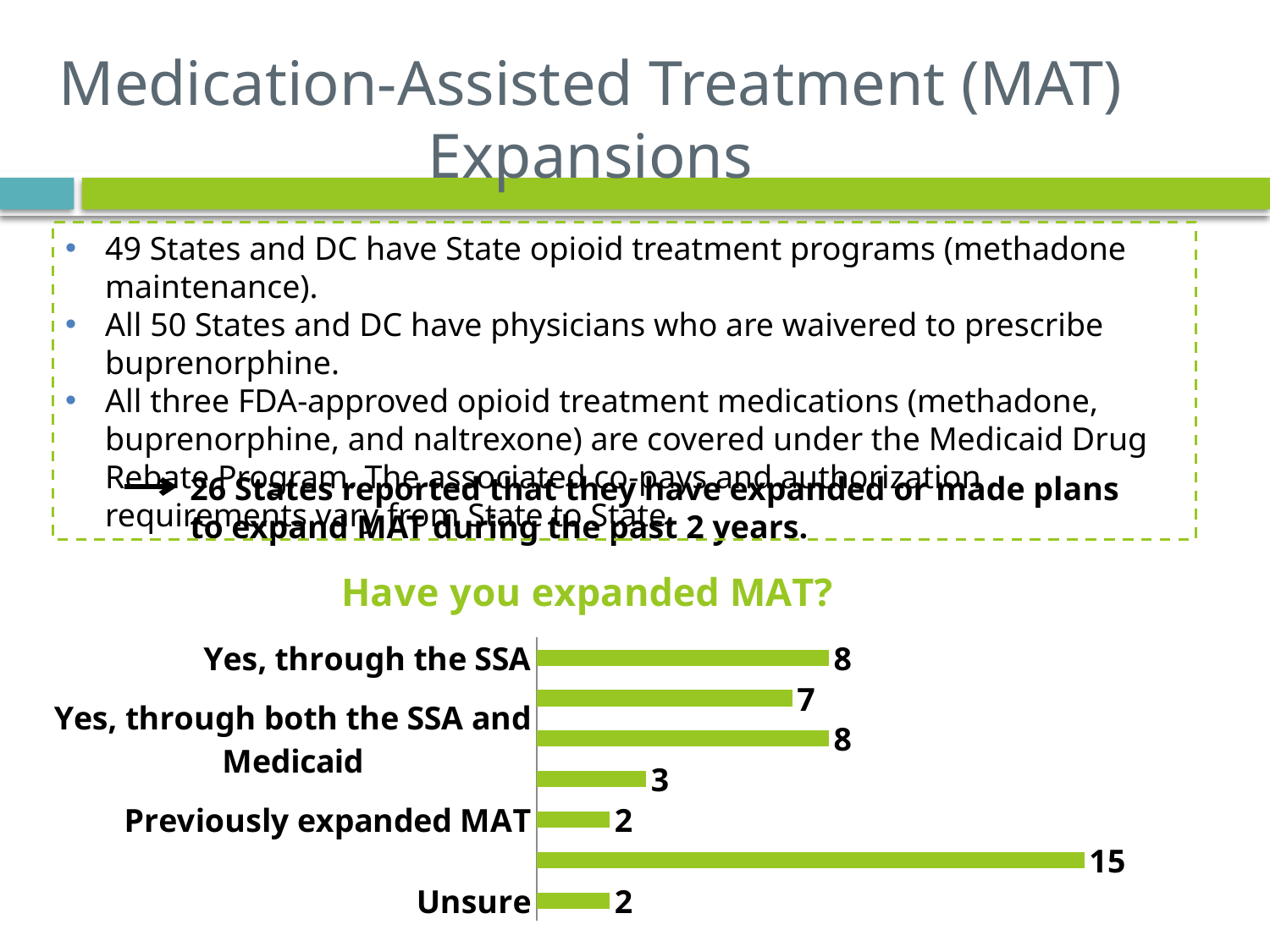
How many bars does the chart show? 7 What is the value for "Yes, through the SSA"? 8 Which is larger, the value for "Yes, through the SSA" or the value for "Unsure"? Yes, through the SSA What colour are the bars in the chart? green What is the sum of all the bar values shown in the chart? 45 What is the value for "Yes, through both the SSA and Medicaid"? 8 What is the value for "Previously expanded MAT"? 2 What kind of chart is shown on the slide? bar chart What is the difference between the value for "Yes, through the SSA" and the value for "Previously expanded MAT"? 6 What is the value for "Unsure"? 2 What is the largest value shown on any bar in the chart? 15 What is the title of the chart? Have you expanded MAT?